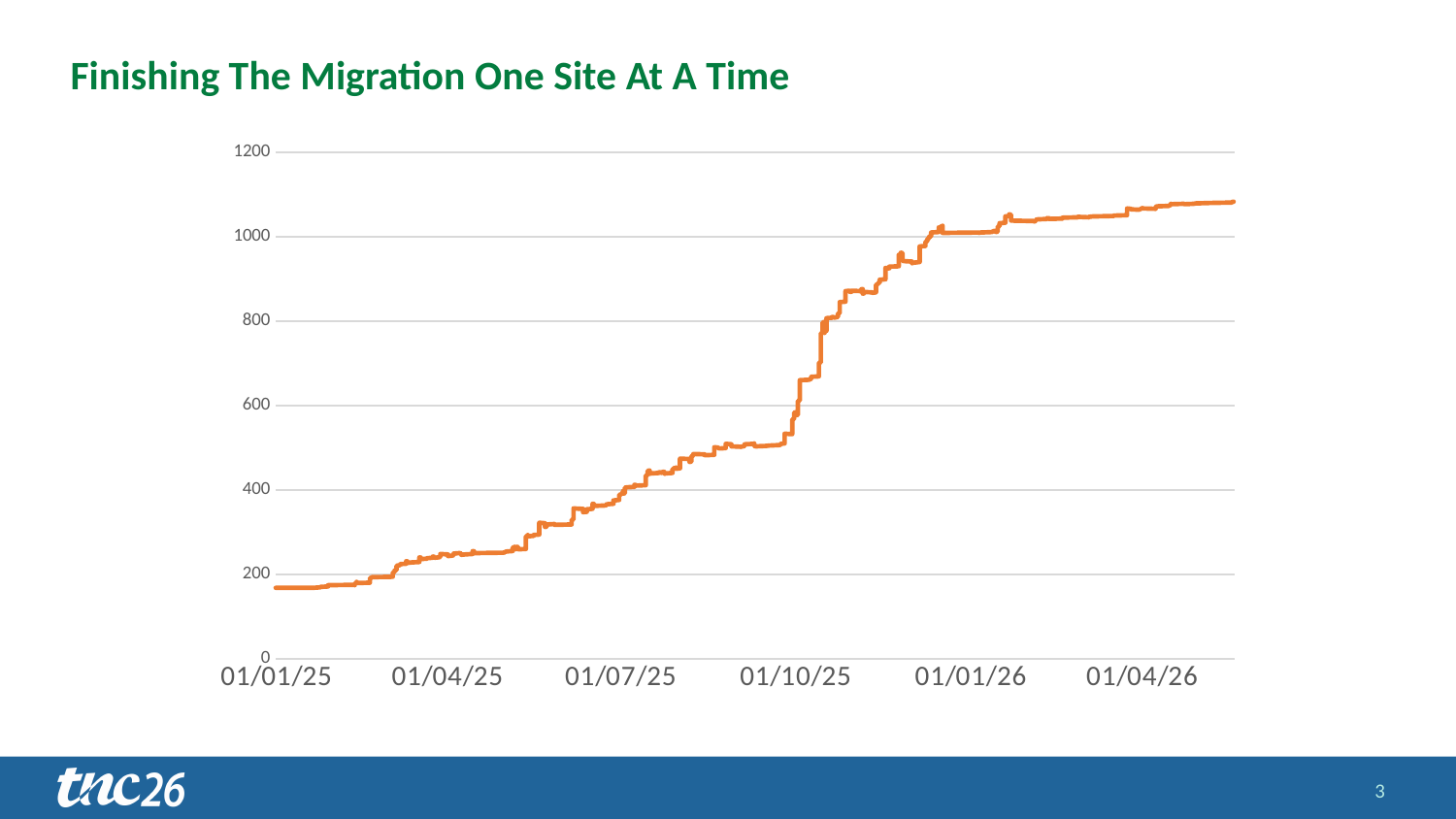
How many date labels are shown on the x axis? 6 What colour is the line on the chart? orange Is the value at 01/10/25 greater or less than 400? greater Is the value at 01/01/25 greater or less than 200? less Is the highest value reached on the chart greater or less than 1200? less Do the values on the chart generally rise or fall from left to right along the x axis? rise What kind of chart is shown on the slide? line chart